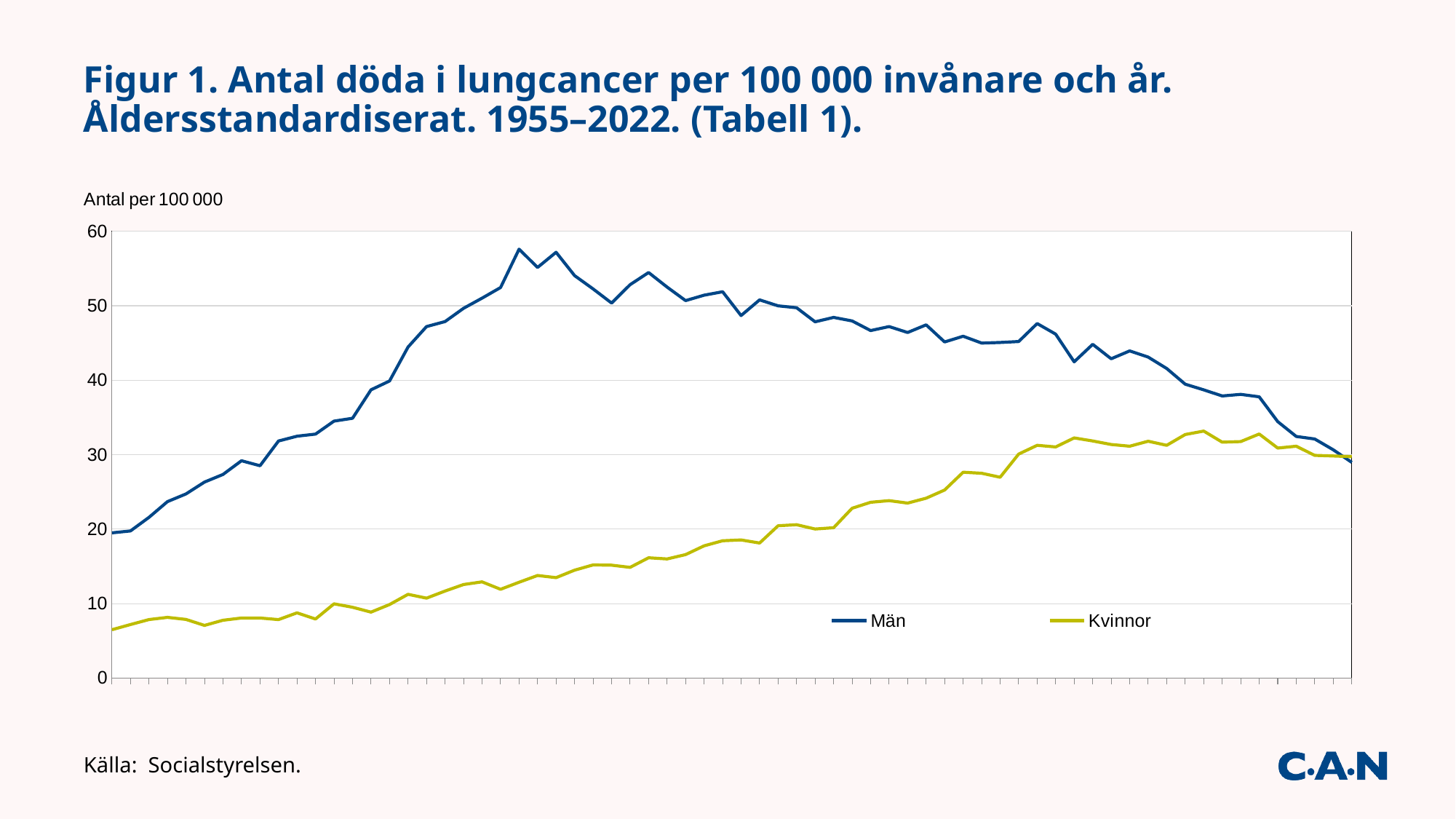
What is the label on the vertical axis of the chart? Antal per 100 000 Does the Män line rise or fall over the last part of the period, after its peak? fall How many series does the legend list? 2 Is the peak value for Kvinnor greater or less than 30? greater Is the peak value for Män greater or less than 50? greater What source is cited below the chart? Socialstyrelsen At the start of the series (1955), which is higher, Män or Kvinnor? Män Does the Kvinnor line generally rise or fall from left to right across the chart? rise What kind of chart is shown on the slide? line chart Which series has the lowest value anywhere on the chart? Kvinnor Is the value for Kvinnor at the start of the series (1955) greater or less than 10? less Which series reaches the highest value anywhere on the chart? Män